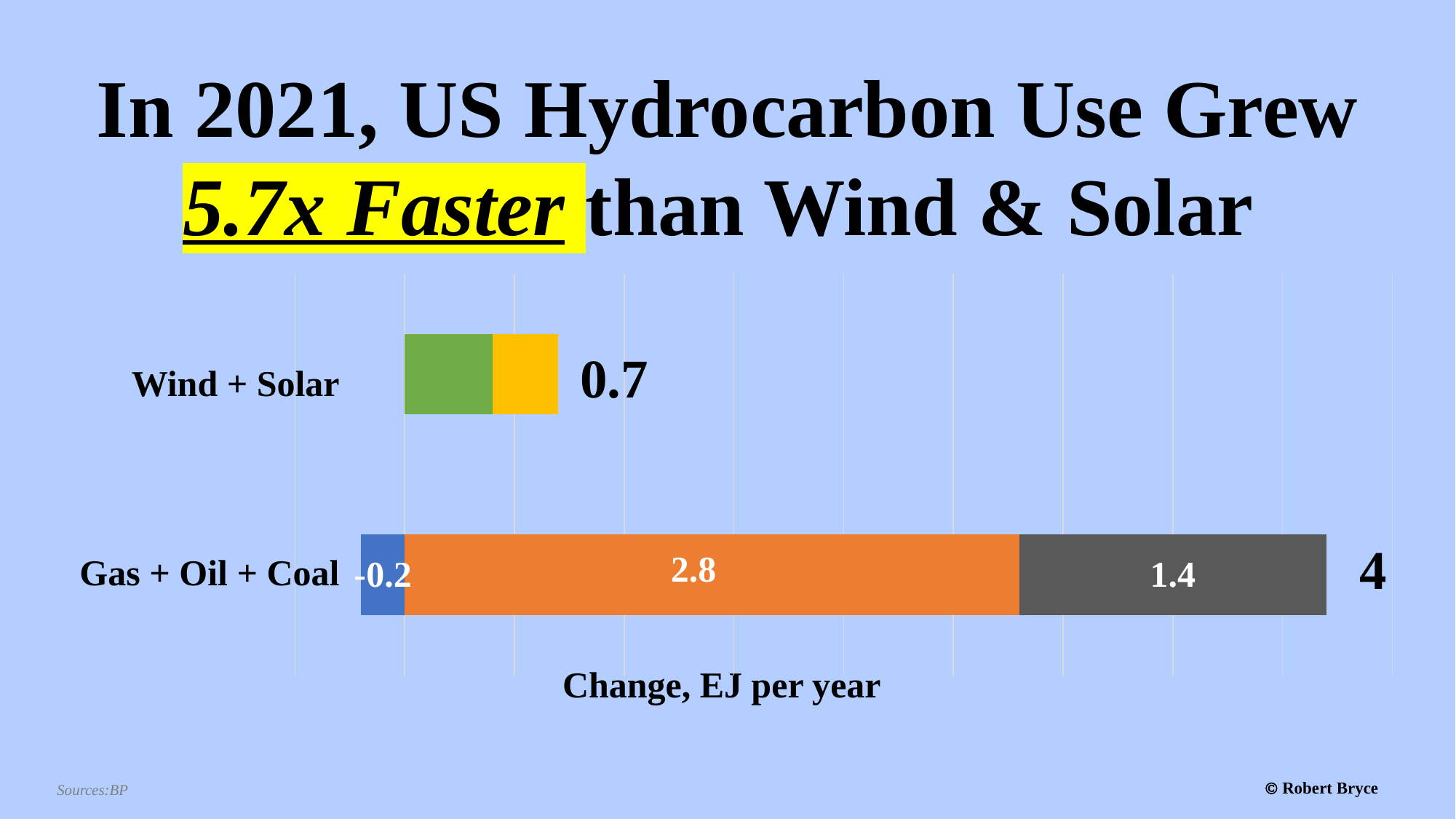
What value is printed on the dark grey segment of the Gas + Oil + Coal bar? 1.4 Which category has the highest total value? Gas + Oil + Coal What is the total value shown for the Gas + Oil + Coal bar? 4 What is the total value shown for the Wind + Solar bar? 0.7 What value is printed on the blue segment of the Gas + Oil + Coal bar? -0.2 What value is printed on the orange segment of the Gas + Oil + Coal bar? 2.8 Which category has the lowest total value? Wind + Solar How many categories are plotted on the chart? 2 What is the difference between the total for Gas + Oil + Coal and the total for Wind + Solar? 3.3 What is the label on the x axis of the chart? Change, EJ per year How many segments make up the Gas + Oil + Coal bar? 3 What kind of chart is shown on the slide? bar chart